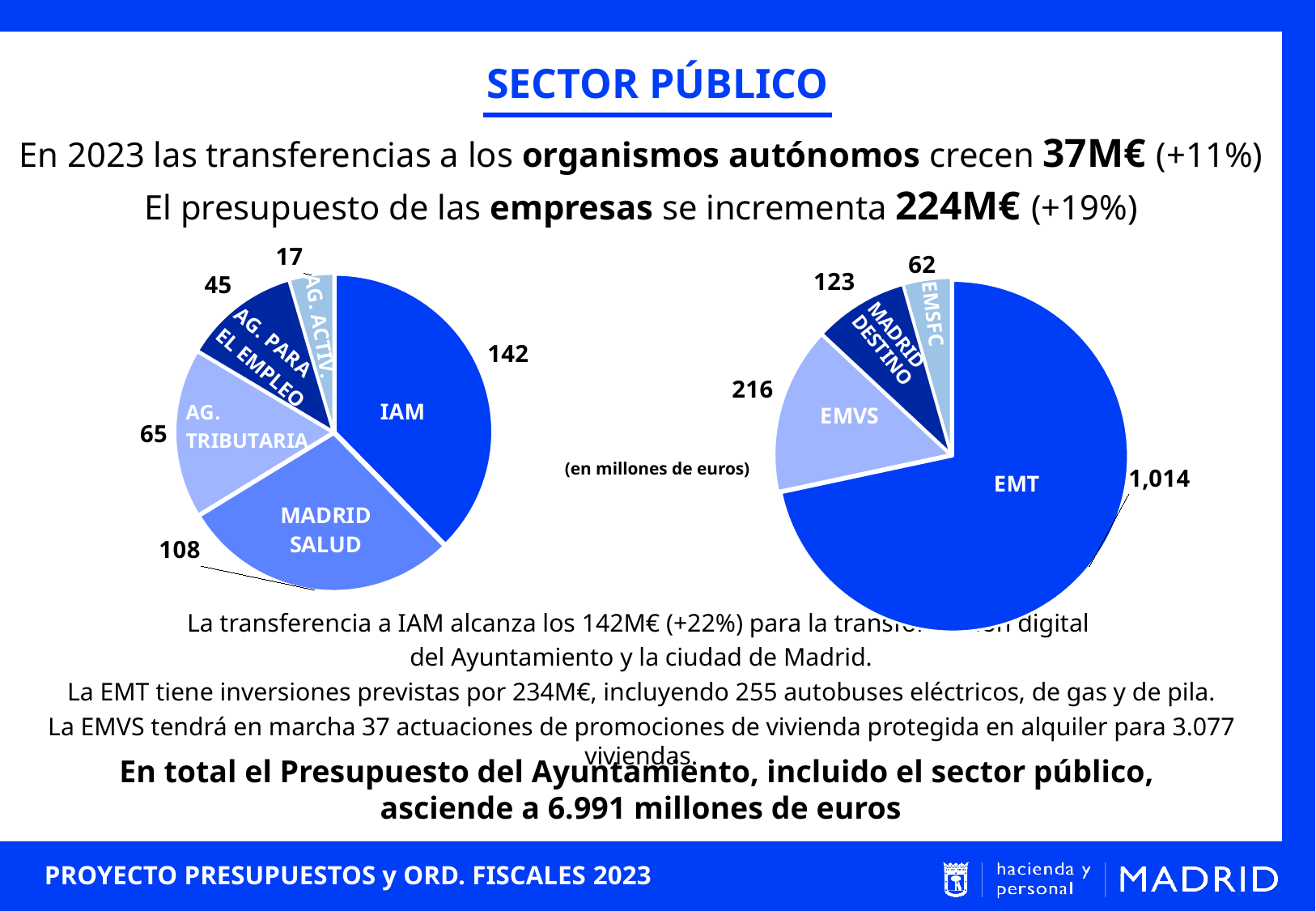
In the left pie chart, what is the value for IAM? 142 In the right pie chart, which category has the largest slice? EMT In the left pie chart, which category has the smallest slice? AG. ACTIV. In the right pie chart, what is the value for EMVS? 216 How many categories does the right pie chart show? 4 In the right pie chart, what is the value for EMT? 1,014 In the left pie chart, what is the difference between the values for IAM and AG. TRIBUTARIA? 77 In the right pie chart, which is larger, MADRID DESTINO or EMSFC? MADRID DESTINO How many categories does the left pie chart show? 5 What type of chart is used on the right side of the slide? Pie chart In the left pie chart, what is the value for MADRID SALUD? 108 What is the sum of all the values shown in the right pie chart? 1,415